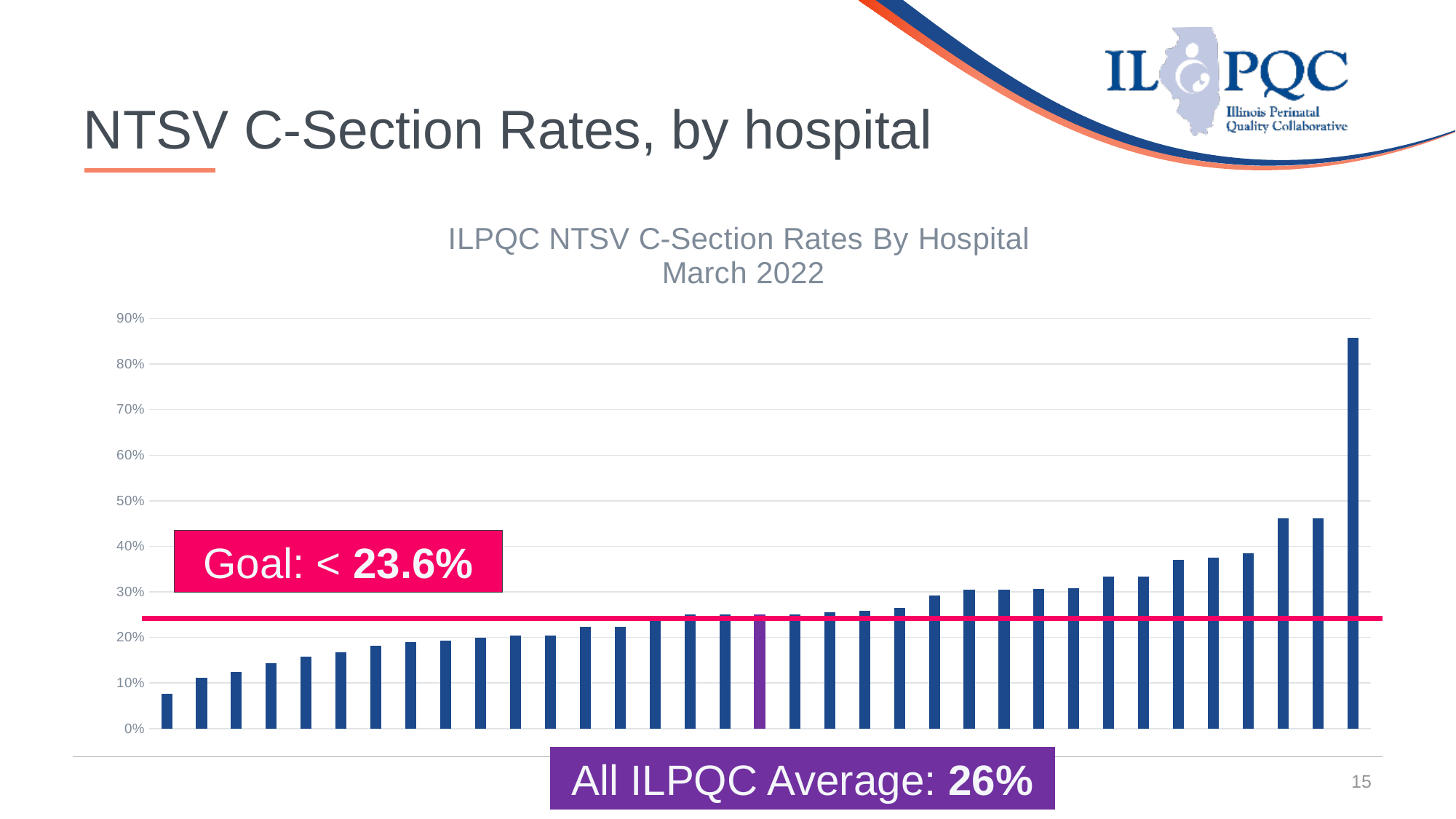
Is the value of the tallest bar greater or less than 80%? greater What is the All ILPQC Average shown on the slide? 26% What colour is the bar that is highlighted differently from the others? purple What goal value is shown in the annotation on the chart? < 23.6% How many bars exceed 40%? 3 Which bar is the highest: the rightmost bar or the leftmost bar? the rightmost bar Do the bar values rise or fall from left to right along the x axis? rise Is the value of the purple bar greater or less than 30%? less What is the title of the chart? ILPQC NTSV C-Section Rates By Hospital March 2022 What kind of chart is shown on the slide? bar chart How many bars exceed 80%? 1 Is the value of the shortest bar (leftmost) greater or less than 10%? less